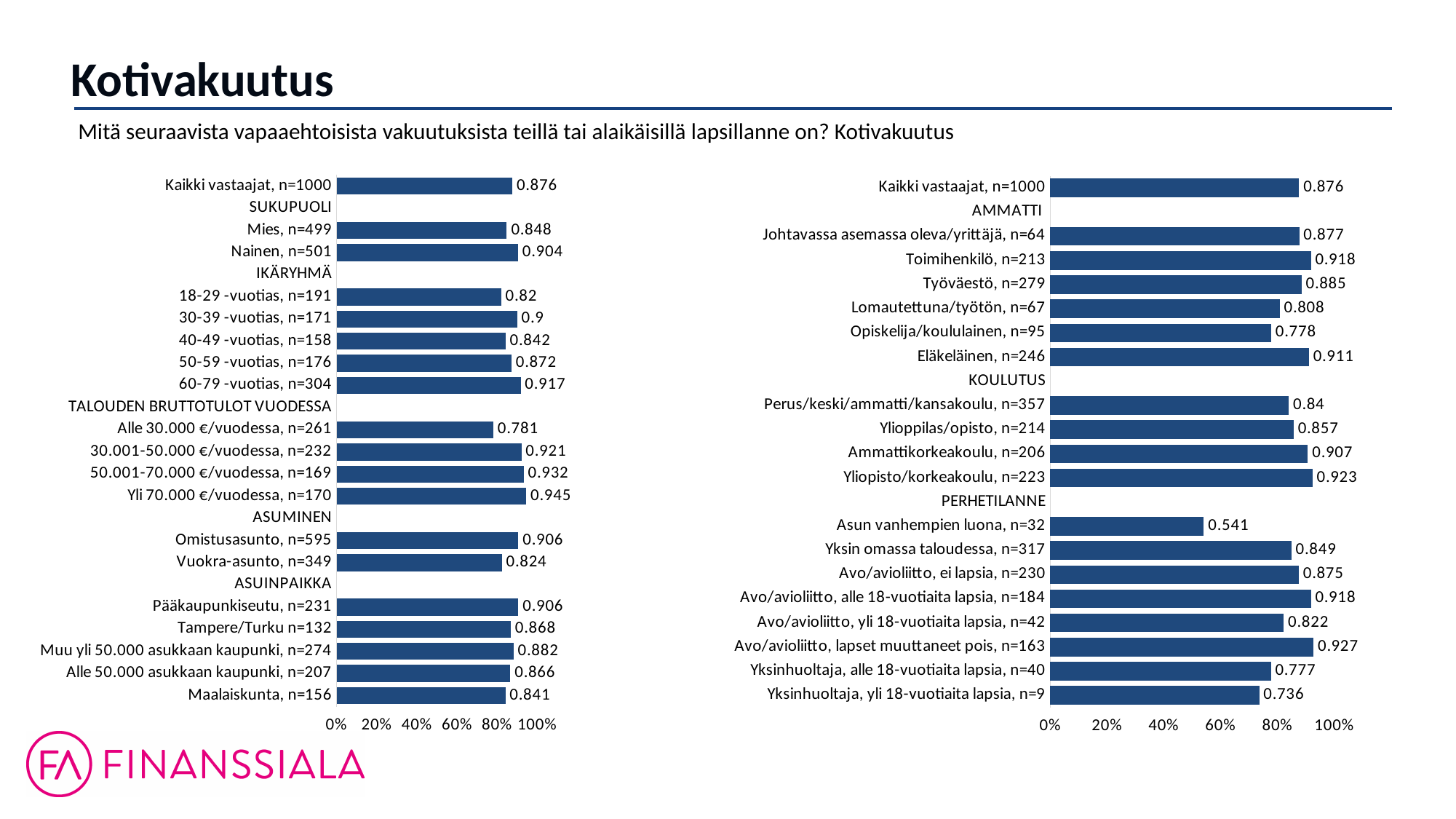
On the right chart, is the value for Asun vanhempien luona, n=32 greater or less than 60%? less On the right chart, what is the value for Eläkeläinen, n=246? 0.911 On the right chart, which is larger: the value for Työväestö, n=279 or Lomautettuna/työtön, n=67? Työväestö, n=279 On the right chart, which category has the lowest value? Asun vanhempien luona, n=32 What kind of chart is shown on the left side of the slide? Bar chart On the left chart, which category has the highest value? Yli 70.000 €/vuodessa, n=170 On the left chart, which category has the lowest value? Alle 30.000 €/vuodessa, n=261 How many bars are plotted on the right chart? 19 On the right chart, what is the difference between the values for Toimihenkilö, n=213 and Opiskelija/koululainen, n=95? 0.14 On the left chart, what is the value for Nainen, n=501? 0.904 On the left chart, what is the difference between the values for Nainen, n=501 and Mies, n=499? 0.056 On the left chart, what is the value for Kaikki vastaajat, n=1000? 0.876